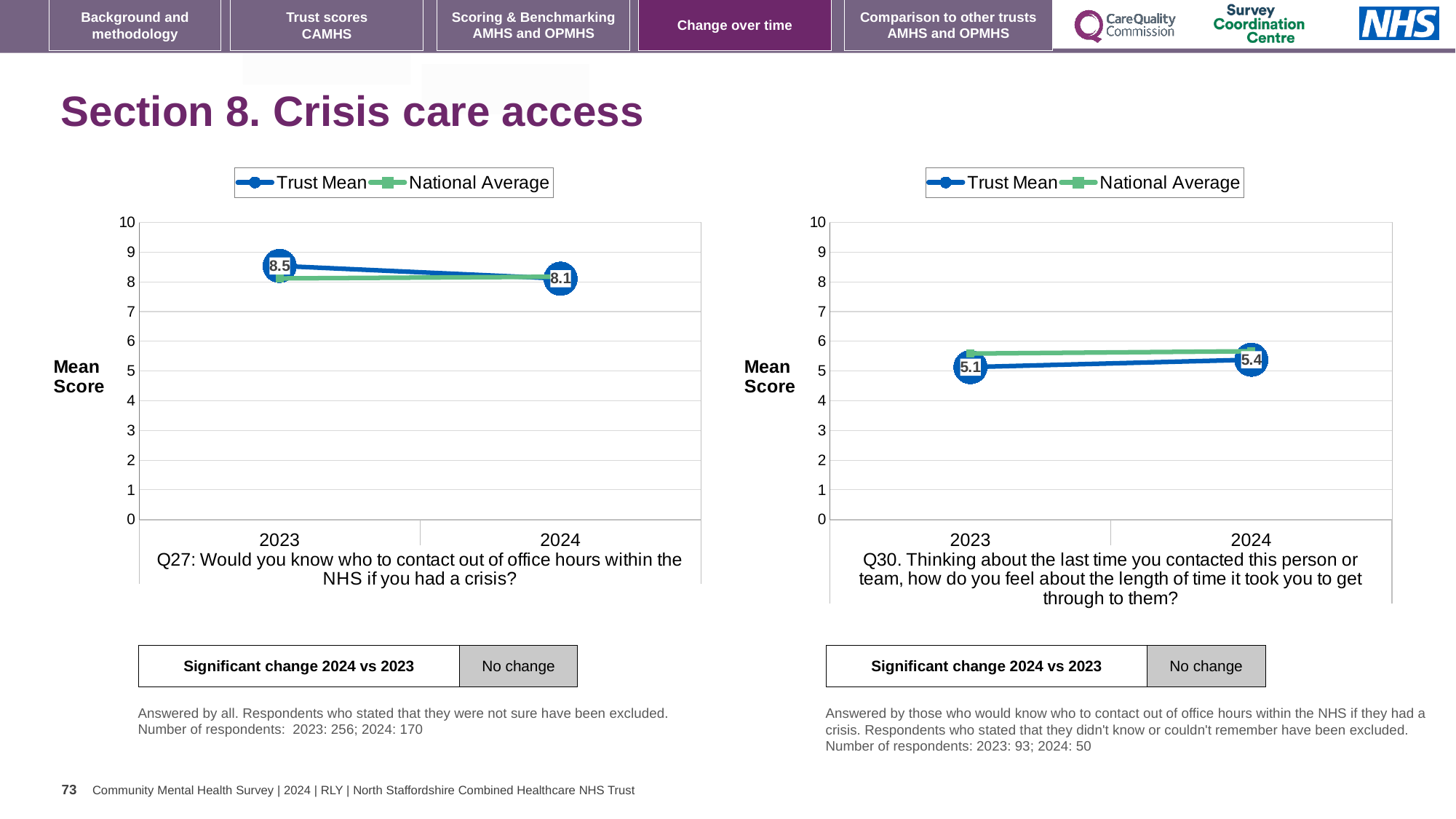
On the Q30 chart (right), does the Trust Mean rise or fall from 2023 to 2024? rise On the Q30 chart (right), what is the Trust Mean score for 2023? 5.1 On the Q27 chart (left), what is the Trust Mean score for 2024? 8.1 On the Q30 chart (right), is the National Average value for 2023 greater or less than 5? greater On the Q30 chart (right), what is the Trust Mean score for 2024? 5.4 On the Q27 chart (left), does the Trust Mean rise or fall from 2023 to 2024? fall On the Q30 chart (right), by how much did the Trust Mean rise from 2023 to 2024? 0.3 On the Q30 chart (right), which is larger in 2023: the Trust Mean or the National Average? National Average How many series does the legend of the Q30 chart (right) list? 2 What kind of chart is the Q27 chart on the left? line chart On the Q27 chart (left), what is the Trust Mean score for 2023? 8.5 On the Q27 chart (left), by how much did the Trust Mean fall from 2023 to 2024? 0.4